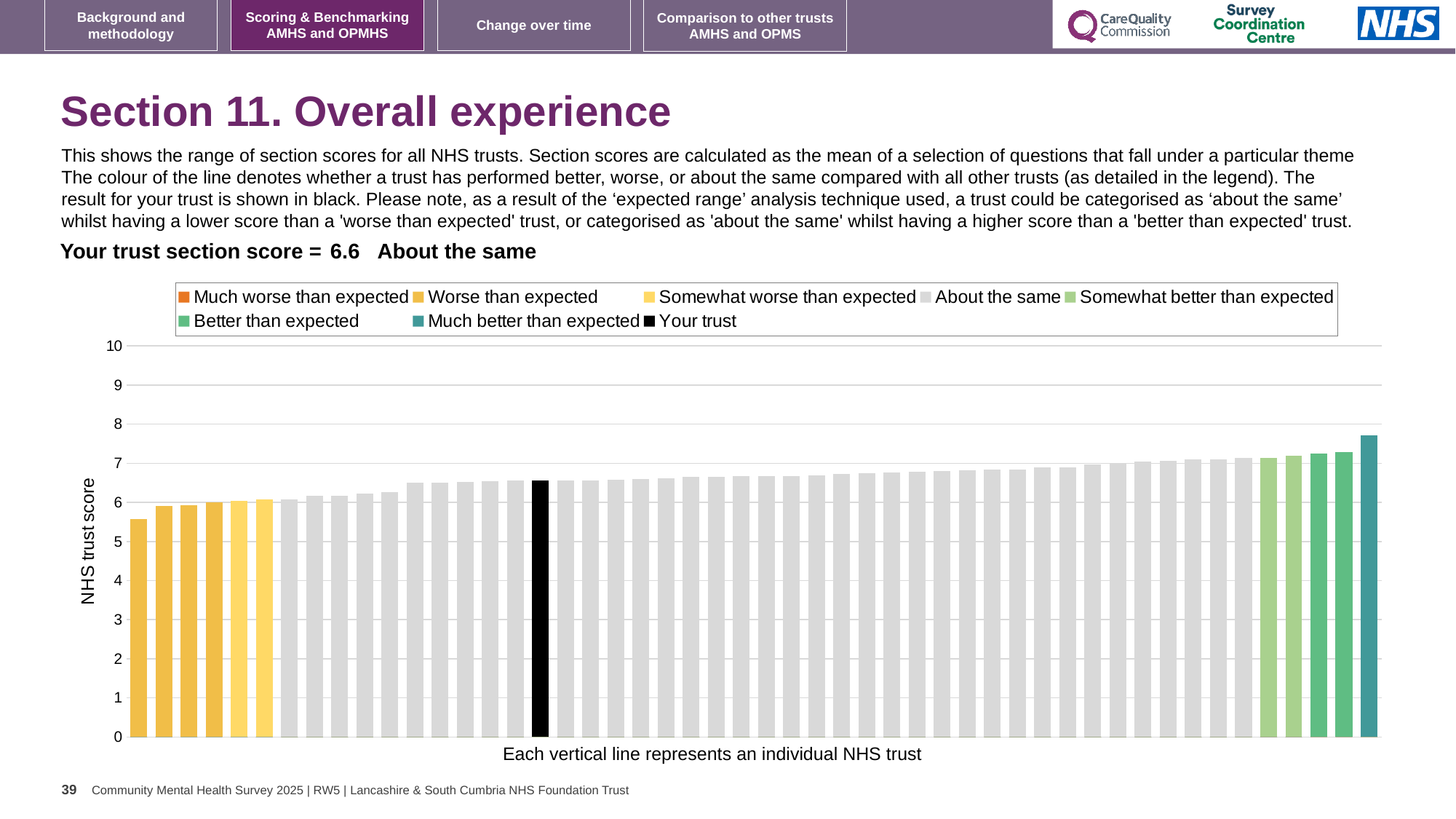
What colour is used for the bar representing your trust? Black Do the bar values rise or fall from left to right along the x axis? Rise What is the section score for your trust shown on the slide? 6.6 Is the value for the highest bar on the chart greater or less than 7? greater What is the label on the vertical axis of the chart? NHS trust score Is the value for the lowest bar on the chart greater or less than 6? less Is the value for your trust (the black bar) greater or less than 6? greater How many entries does the chart legend list? 8 Which category is your trust placed in for this section? About the same What kind of chart is shown on the slide? Bar chart Which legend category does the lowest-scoring trust (leftmost bar) belong to? Worse than expected Which legend category does the highest-scoring trust (rightmost bar) belong to? Much better than expected